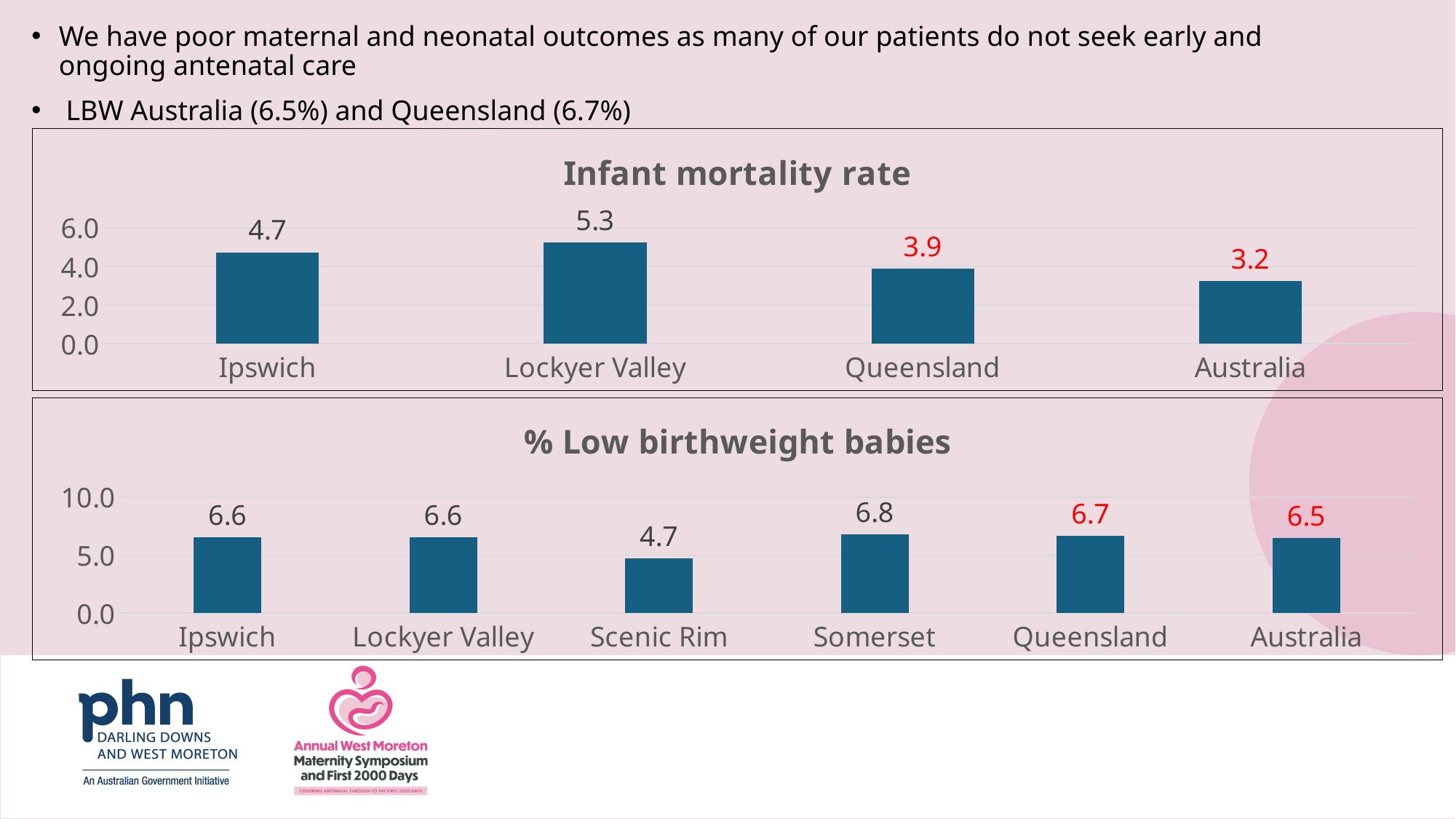
In the 'Infant mortality rate' chart, which category has the highest value? Lockyer Valley In the '% Low birthweight babies' chart, what is the value for Somerset? 6.8 In the 'Infant mortality rate' chart, what is the difference between Ipswich and Queensland? 0.8 In the 'Infant mortality rate' chart, what is the value for Lockyer Valley? 5.3 In the 'Infant mortality rate' chart, which category has the lowest value? Australia In the '% Low birthweight babies' chart, how many categories are shown? 6 What kind of chart is the 'Infant mortality rate' chart? bar chart In the 'Infant mortality rate' chart, how many categories are shown? 4 In the '% Low birthweight babies' chart, which category has the highest value? Somerset In the '% Low birthweight babies' chart, what is the difference between Ipswich and Scenic Rim? 1.9 In the '% Low birthweight babies' chart, is the value for Queensland larger or smaller than the value for Australia? larger In the '% Low birthweight babies' chart, which category has the lowest value? Scenic Rim